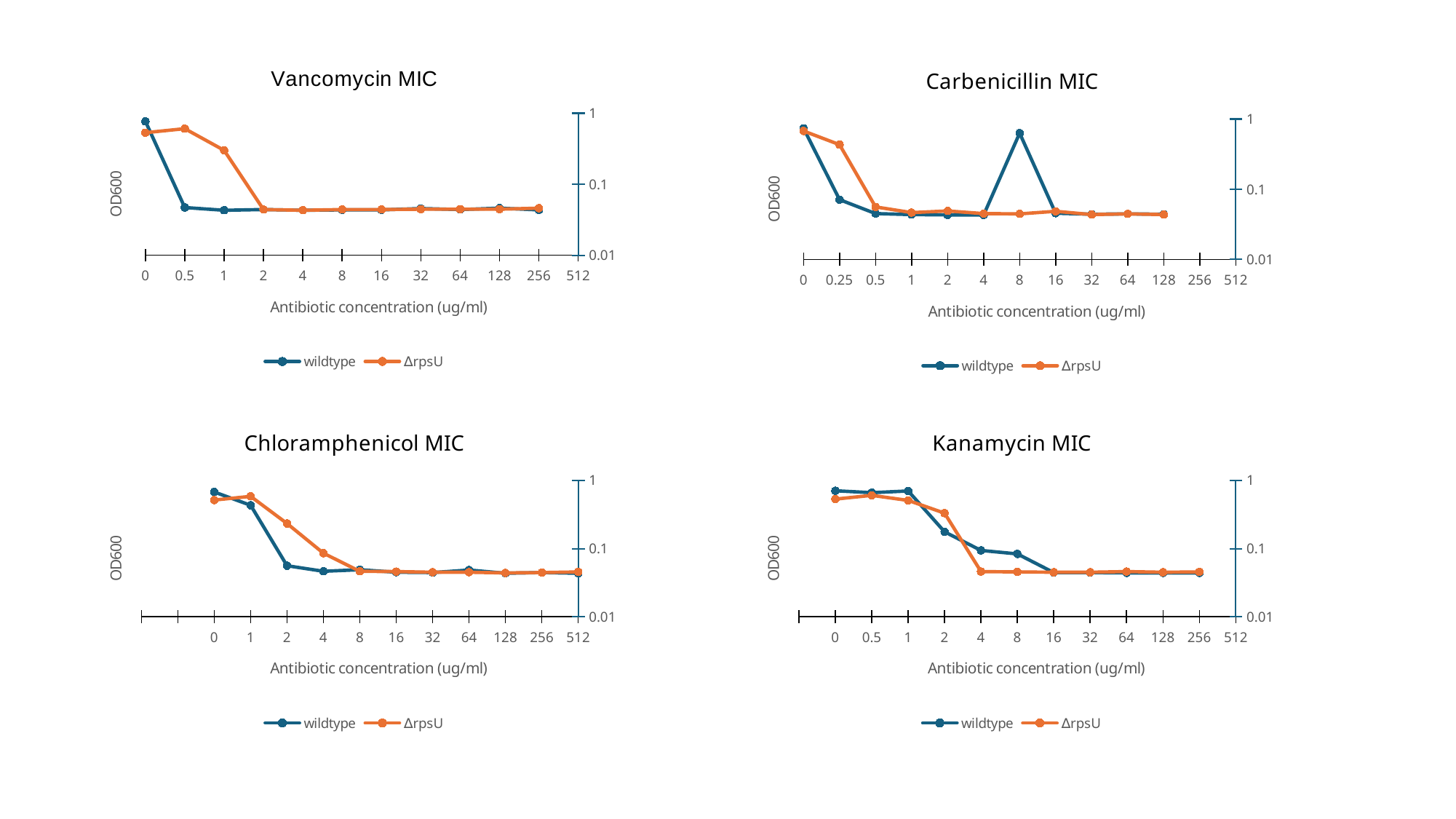
What kind of chart is the Vancomycin MIC chart? line chart What is the label of the y axis on the Kanamycin MIC chart? OD600 In the Carbenicillin MIC chart, is the wildtype value at 8 ug/ml greater or less than 0.1? greater In the Carbenicillin MIC chart, which series has the higher OD600 at 0.25 ug/ml, wildtype or ΔrpsU? ΔrpsU In the Vancomycin MIC chart, is the wildtype value at 0.5 ug/ml greater or less than 0.1? less In the Chloramphenicol MIC chart, which series has the higher OD600 at 4 ug/ml, wildtype or ΔrpsU? ΔrpsU In the Vancomycin MIC chart, which series has the higher OD600 at 1 ug/ml, wildtype or ΔrpsU? ΔrpsU In the Vancomycin MIC chart, is the ΔrpsU value at 0.5 ug/ml greater or less than 0.1? greater In the Kanamycin MIC chart, do the ΔrpsU values generally rise or fall as antibiotic concentration increases? fall How many series does the legend of the Carbenicillin MIC chart list? 2